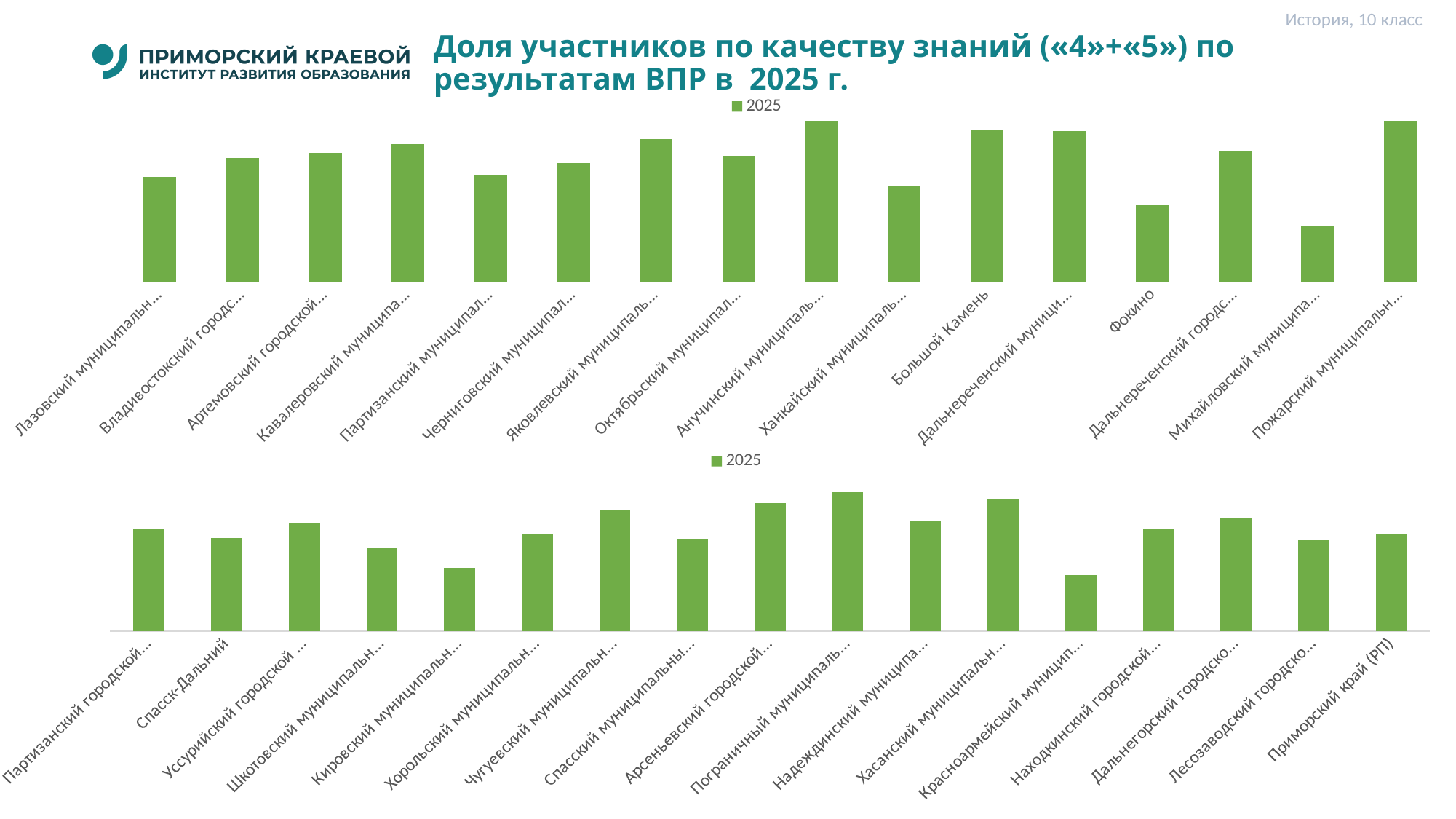
How many categories are plotted in the bottom chart? 17 How many series does the legend of the top chart list? 1 In the bottom chart, which category has the highest value? Пограничный What kind of chart is the top chart on the slide? bar chart In the bottom chart, which is larger, the value for Спасск-Дальний or for Уссурийский? Уссурийский What kind of chart is the bottom chart on the slide? bar chart What is the legend entry shown for the bottom chart? 2025 In the top chart, which category has the lowest value? Михайловский In the top chart, which is larger, the value for Фокино or for Большой Камень? Большой Камень How many categories are plotted in the top chart? 16 What colour are the bars in both charts? green